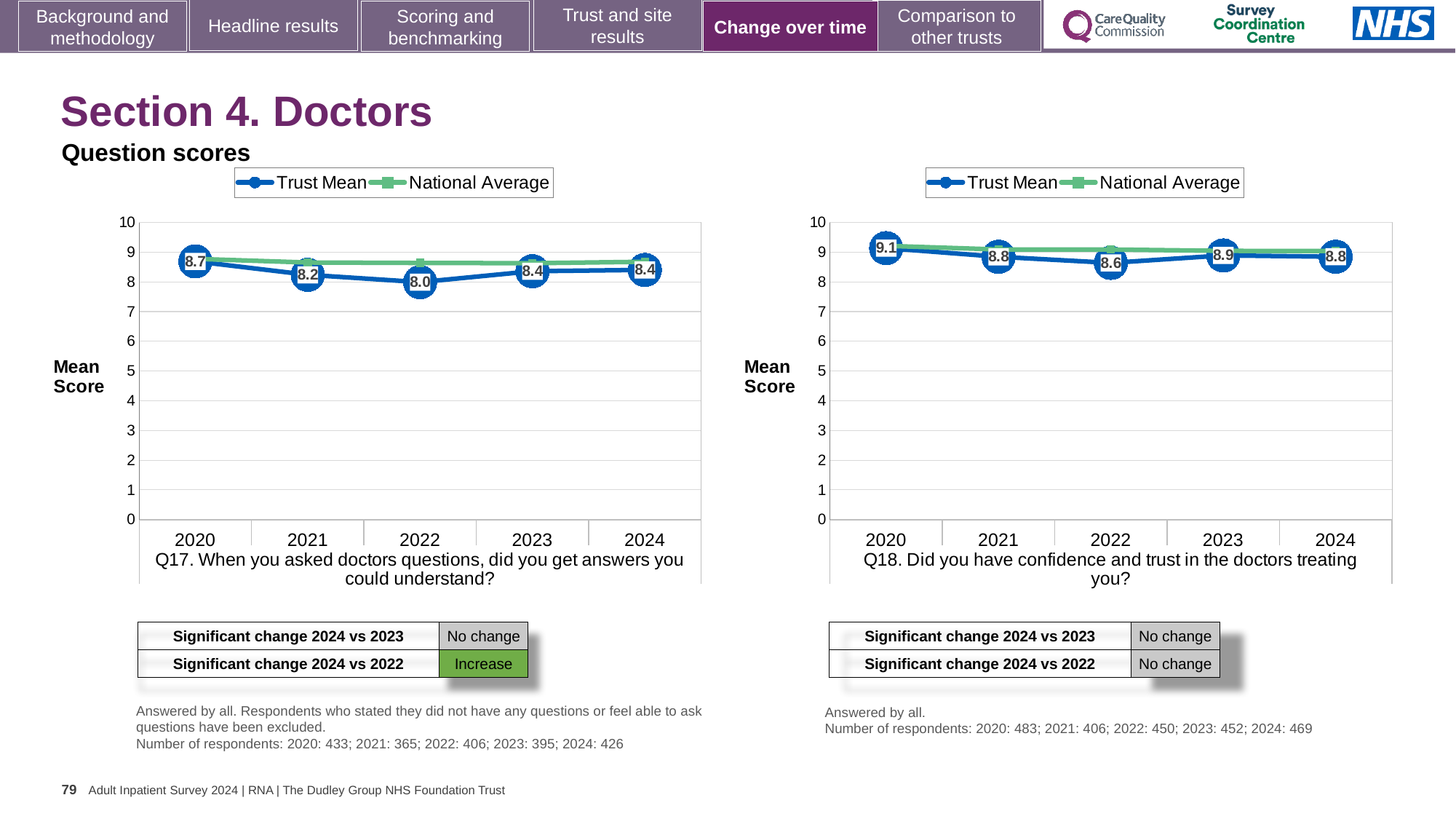
What type of chart is the Q17 chart? Line chart In the Q18 chart, what is the Trust Mean score for 2020? 9.1 In the Q17 chart, what is the difference between the Trust Mean scores for 2020 and 2022? 0.7 In the Q17 chart, what is the Trust Mean score for 2020? 8.7 In the Q18 chart, is the Trust Mean score for 2021 or 2022 larger? 2021 In the Q17 chart, what is the Trust Mean score for 2022? 8.0 How many series does the legend of the Q17 chart list? 2 In the Q17 chart, which year has the lowest Trust Mean score? 2022 In the Q18 chart, what is the Trust Mean score for 2023? 8.9 How many years are plotted on the x axis of the Q18 chart? 5 In the Q17 chart, which year has the highest Trust Mean score? 2020 In the Q18 chart, which year has the lowest Trust Mean score? 2022